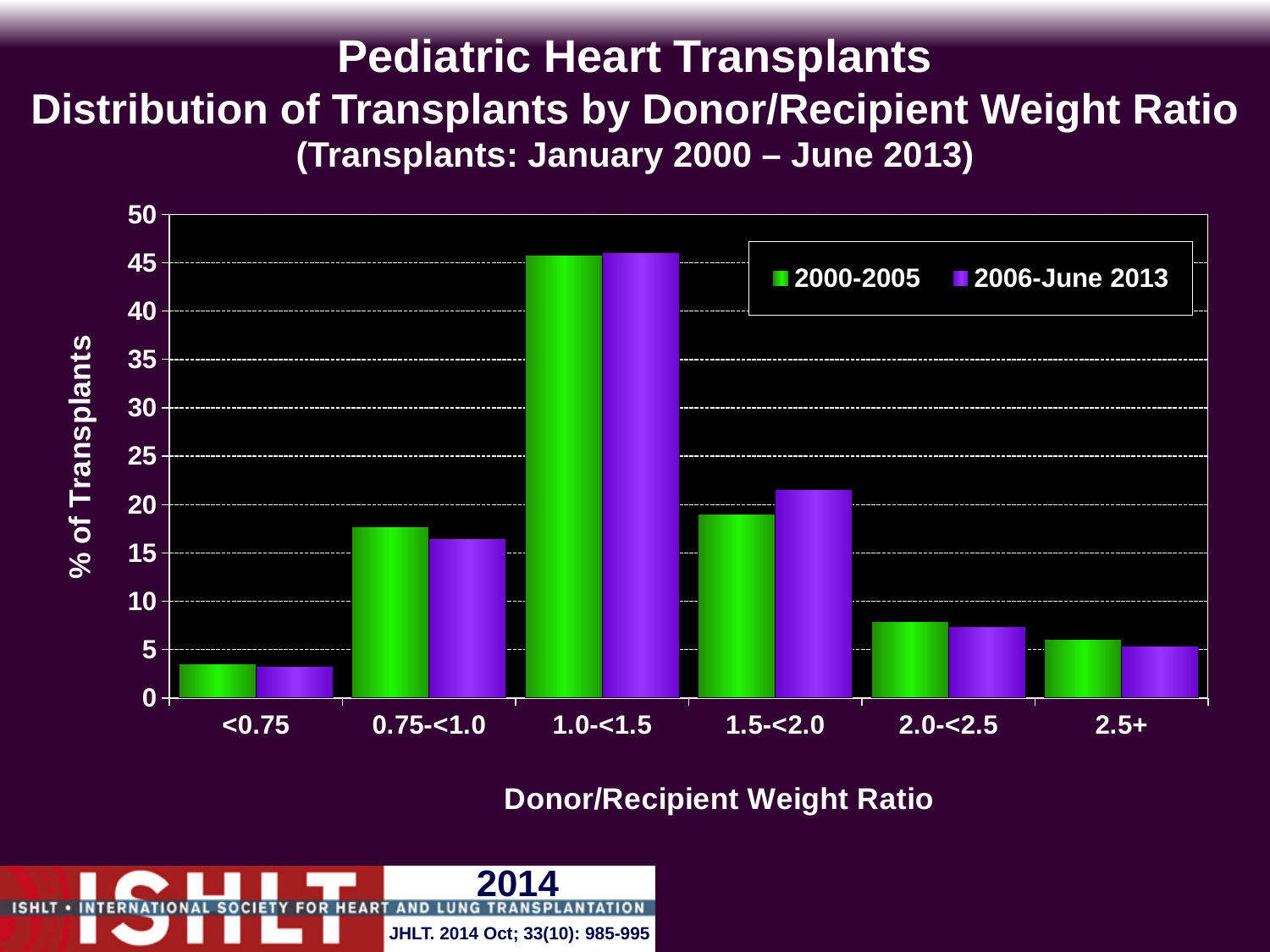
Is the value for 2006-June 2013 in the 1.5-<2.0 category greater or less than 20? greater How many donor/recipient weight ratio categories are shown on the x axis? 6 Is the value for 2006-June 2013 in the 2.0-<2.5 category greater or less than 10? less Which weight ratio category has the lowest value for the 2006-June 2013 series? <0.75 For the 1.5-<2.0 category, which series has the larger value, 2000-2005 or 2006-June 2013? 2006-June 2013 Is the value for 2000-2005 in the <0.75 category greater or less than 5? less What kind of chart is shown on the slide? bar chart For the 0.75-<1.0 category, which series has the larger value, 2000-2005 or 2006-June 2013? 2000-2005 What is the label of the y axis? % of Transplants Which weight ratio category has the highest value for the 2000-2005 series? 1.0-<1.5 How many series does the legend list? 2